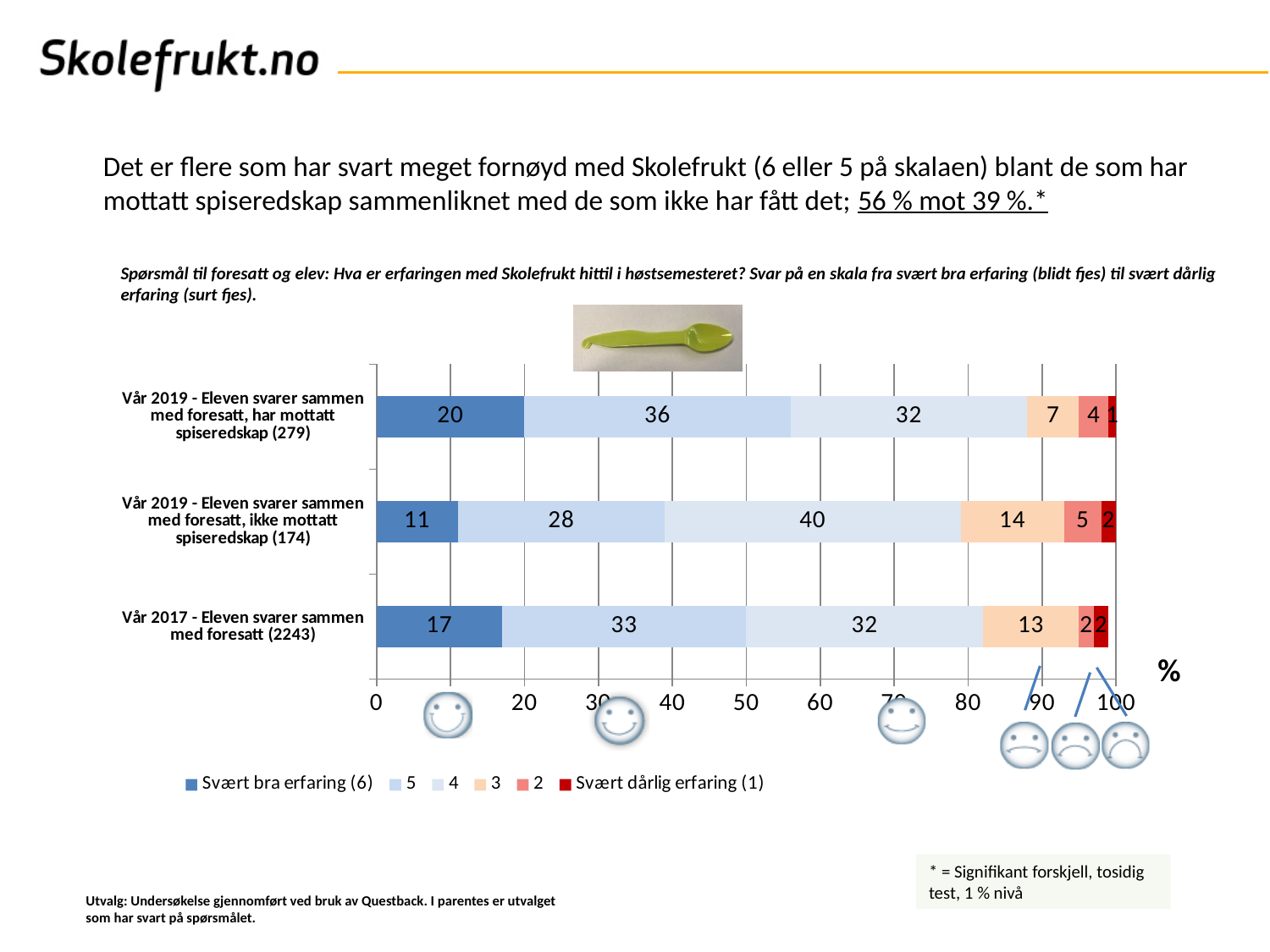
Which category has the highest value for 'Svært bra erfaring (6)'? Vår 2019 - Eleven svarer sammen med foresatt, har mottatt spiseredskap (279) What is the total of the stacked bar for 'Vår 2019 - Eleven svarer sammen med foresatt, har mottatt spiseredskap (279)'? 100 How many series does the legend list? 6 What is the value of 'Svært bra erfaring (6)' for 'Vår 2019 - Eleven svarer sammen med foresatt, har mottatt spiseredskap (279)'? 20 What is the value of series '4' for 'Vår 2019 - Eleven svarer sammen med foresatt, ikke mottatt spiseredskap (174)'? 40 What kind of chart is shown on the slide? Stacked bar chart What is the label of the first legend entry? Svært bra erfaring (6) What is the difference between the 'Svært bra erfaring (6)' values for the 2019 group that received spiseredskap (279) and the 2019 group that did not (174)? 9 How many categories (bars) are plotted in the chart? 3 Which is larger: the value of series '3' for the 2019 group that did not receive spiseredskap (174) or for the 2019 group that received spiseredskap (279)? Vår 2019 - Eleven svarer sammen med foresatt, ikke mottatt spiseredskap (174) Which category has the lowest value for series '5'? Vår 2019 - Eleven svarer sammen med foresatt, ikke mottatt spiseredskap (174) What is the value of series '3' for 'Vår 2017 - Eleven svarer sammen med foresatt (2243)'? 13